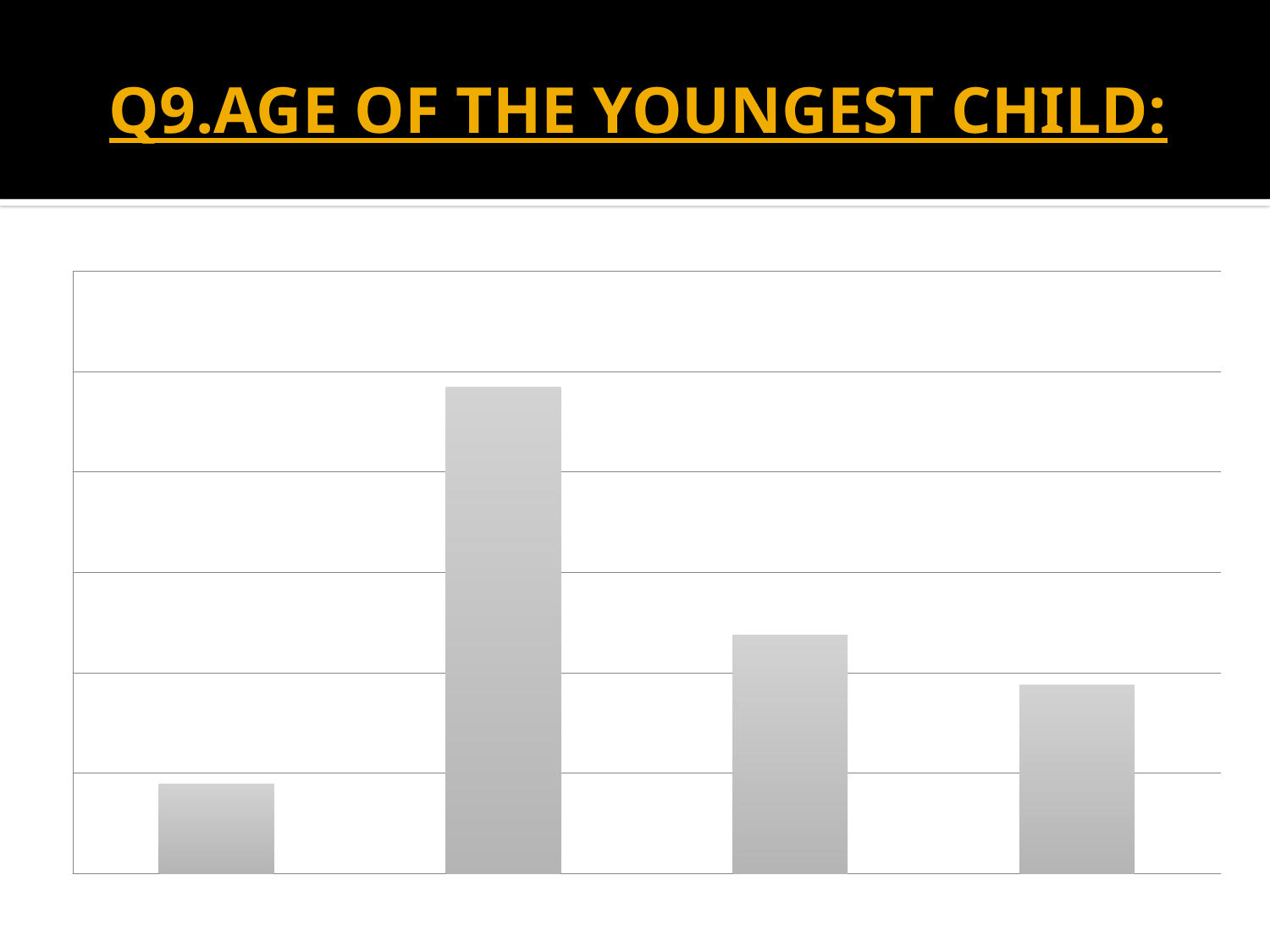
What is the title of the slide containing the chart? Q9.AGE OF THE YOUNGEST CHILD: Which is taller, the second bar or the third bar from the left? the second bar Which bar is the tallest in the chart, counting from the left? the second bar Which is taller, the third bar or the fourth bar from the left? the third bar Does the chart display a legend? No Which is taller, the first bar or the fourth bar from the left? the fourth bar How many bars are plotted in the chart? 4 What kind of chart is shown on the slide? bar chart Which bar is the shortest in the chart, counting from the left? the first bar